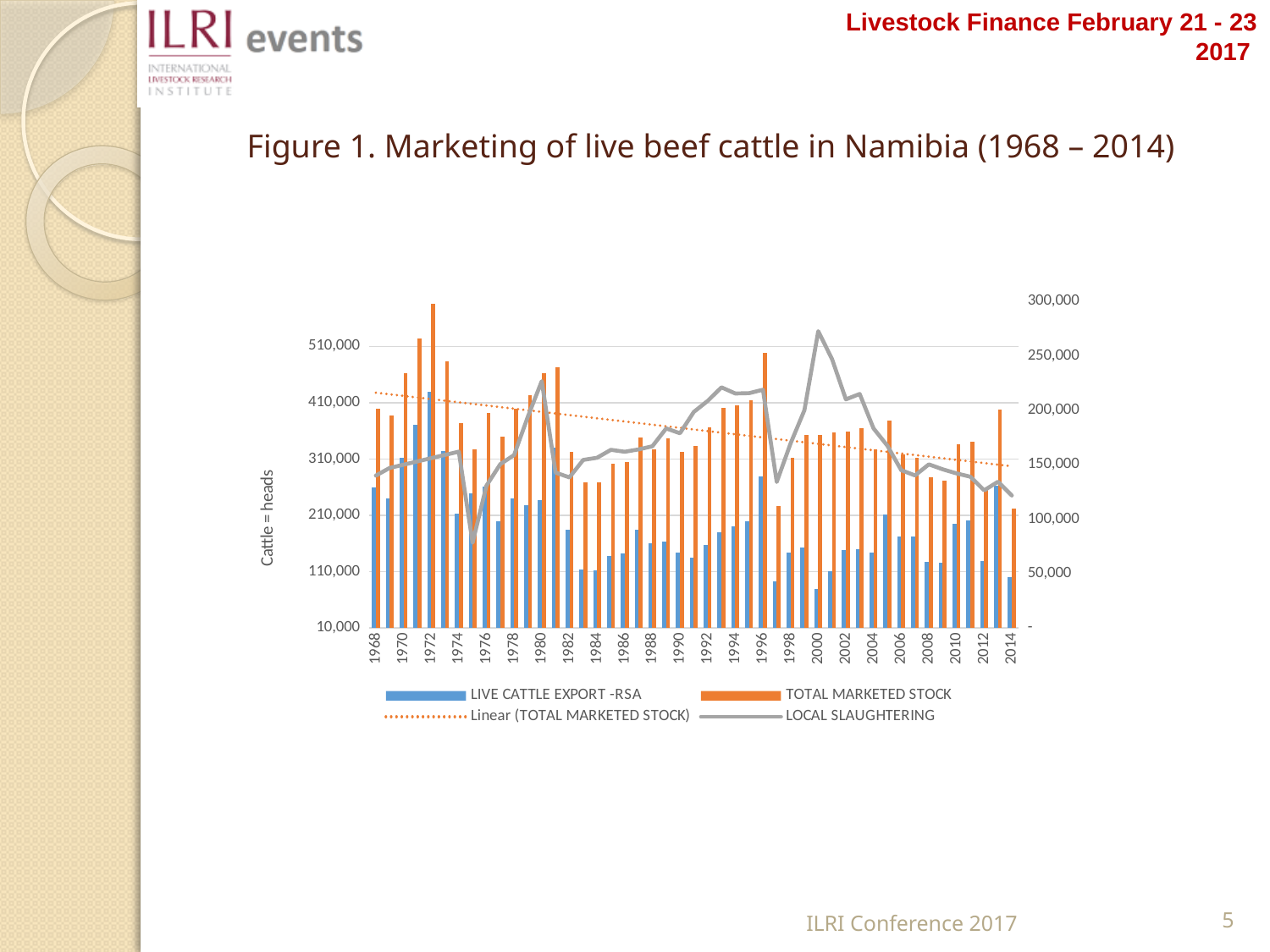
Is the LIVE CATTLE EXPORT -RSA value for 1968 greater or less than 210,000? greater In which year does the LOCAL SLAUGHTERING line reach its peak? 2000 Which is larger, the LIVE CATTLE EXPORT -RSA in 1972 or in 1984? 1972 Is the LOCAL SLAUGHTERING value for 2000 greater or less than 250,000? greater In which year is the TOTAL MARKETED STOCK bar the highest? 1972 What is the label on the left vertical axis? Cattle = heads Does the Linear (TOTAL MARKETED STOCK) trendline rise or fall from 1968 to 2014? Fall Is the TOTAL MARKETED STOCK value for 1972 greater or less than 510,000? greater How many series does the legend list? 4 What kind of chart is shown on the slide? A combined bar and line chart Which is larger, the TOTAL MARKETED STOCK in 1972 or in 1984? 1972 What is the title of the chart? Figure 1. Marketing of live beef cattle in Namibia (1968 – 2014)